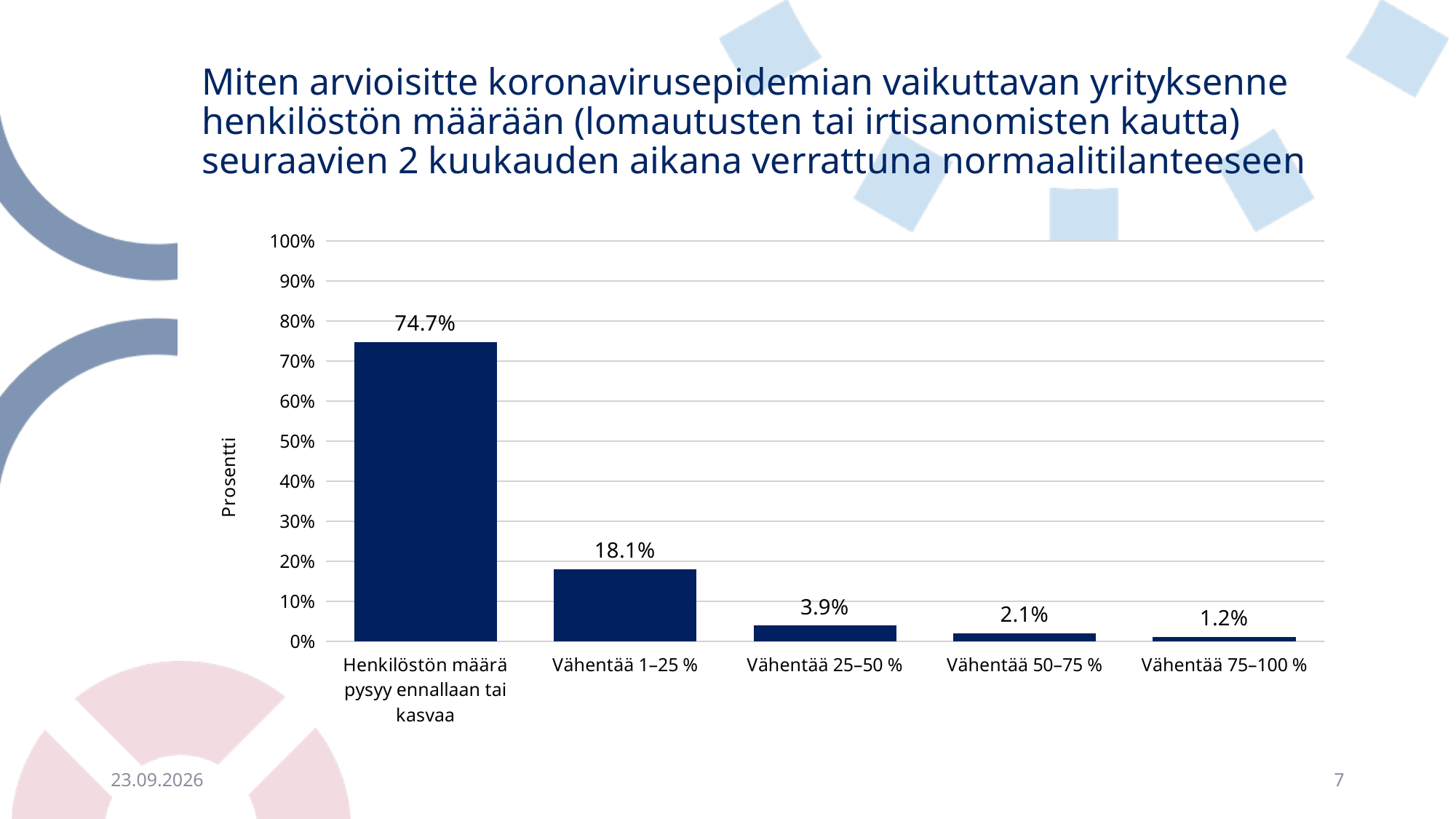
What is the difference between the values for "Henkilöstön määrä pysyy ennallaan tai kasvaa" and "Vähentää 1–25 %"? 56.6% Which category has the lowest value? Vähentää 75–100 % What is the label of the vertical axis? Prosentti What is the value for "Vähentää 1–25 %"? 18.1% Is the value for "Vähentää 1–25 %" greater or less than 20%? less What is the value for "Vähentää 25–50 %"? 3.9% What is the value for "Henkilöstön määrä pysyy ennallaan tai kasvaa"? 74.7% Which category has the highest value? Henkilöstön määrä pysyy ennallaan tai kasvaa What is the value for "Vähentää 75–100 %"? 1.2% Which is larger, the value for "Vähentää 25–50 %" or "Vähentää 50–75 %"? Vähentää 25–50 % How many categories are shown on the x axis? 5 What kind of chart is shown on the slide? bar chart